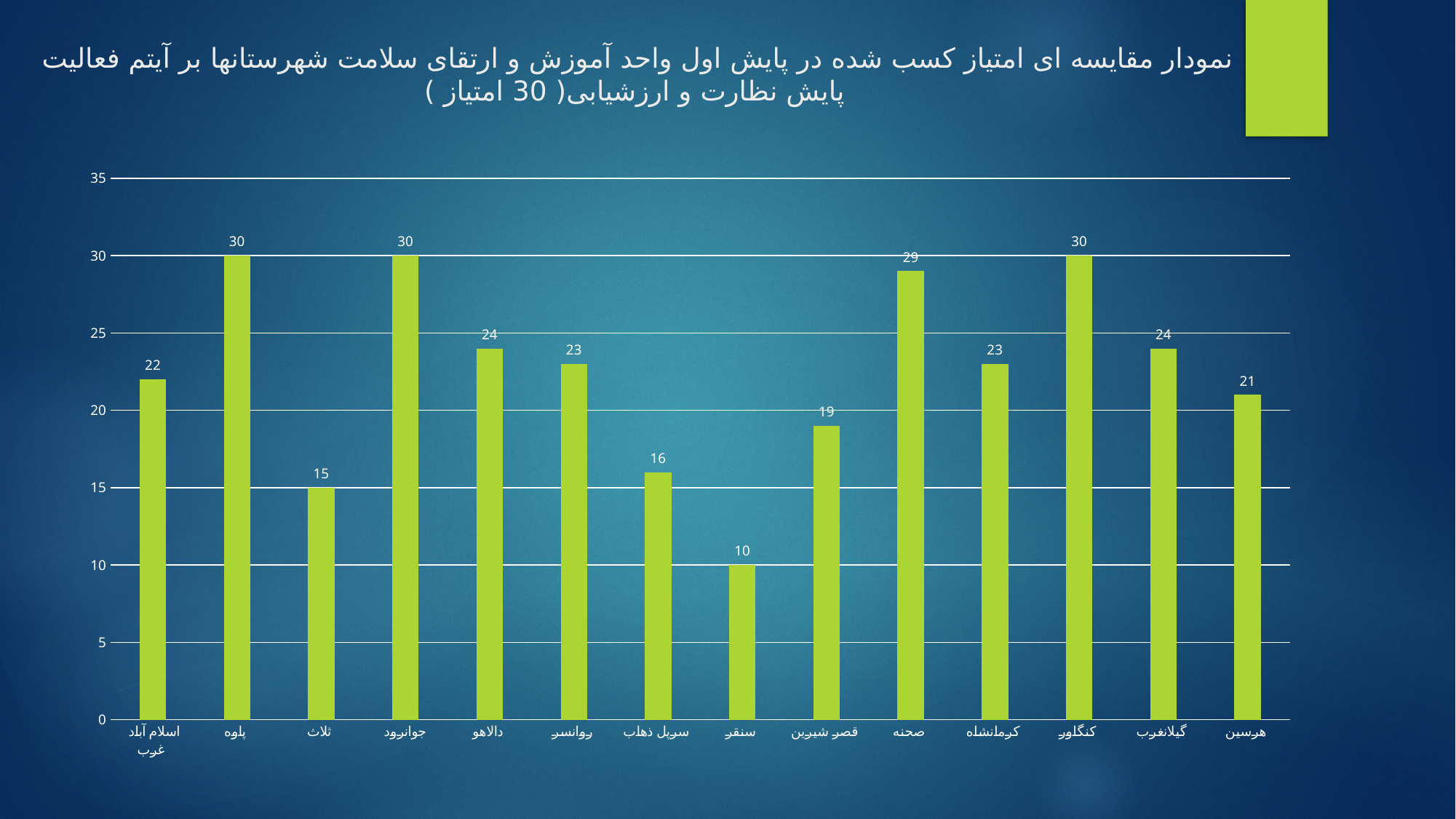
What is the difference between the values for پاوه and ثلاث? 15 Which is larger, the value for سرپل ذهاب or the value for کرمانشاه? کرمانشاه Is the value for گیلانغرب greater or less than 20? greater What is the highest value shown on the y axis? 35 What is the value for قصر شیرین? 19 What is the value for صحنه? 29 What is the value for اسلام آباد غرب? 22 What is the value for سنقر? 10 What is the difference between the values for دالاهو and هرسین? 3 What kind of chart is shown on the slide? bar chart Which category has the lowest value? سنقر How many categories are shown on the x axis? 14